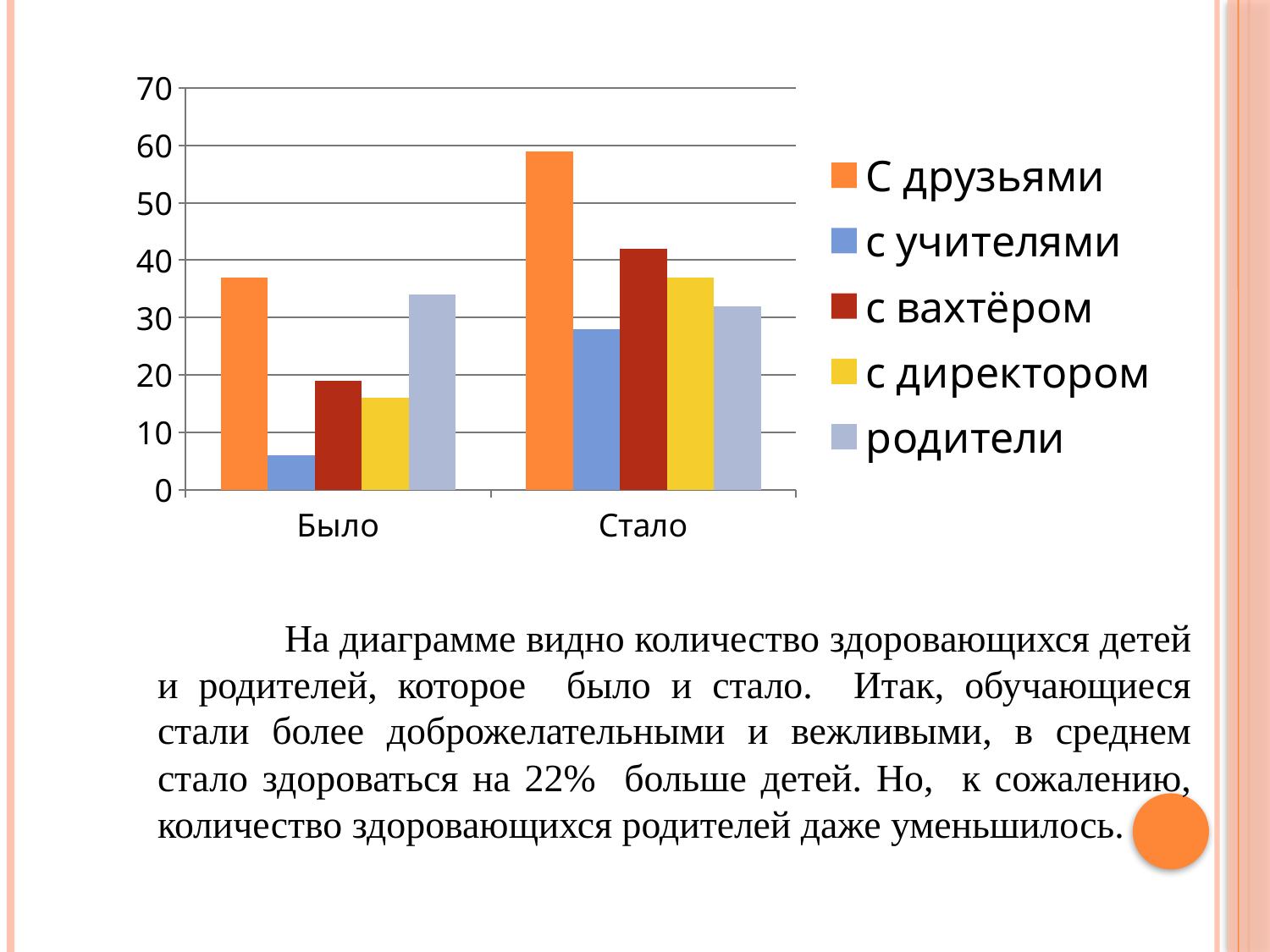
Is the value for "с учителями" in the "Стало" category greater or less than 20? greater Which is larger: the value for "С друзьями" in "Было" or in "Стало"? Стало Which series has the lowest value in the "Стало" category? с учителями Which colour represents the "родители" series in the legend? light blue Which series has the lowest value in the "Было" category? с учителями Is the value for "с учителями" in the "Было" category greater or less than 10? less Which series has the highest value in the "Стало" category? С друзьями Is the value for "С друзьями" in the "Стало" category greater or less than 50? greater What type of chart is shown on the slide? bar chart How many categories are shown on the x axis? 2 How many series does the legend list? 5